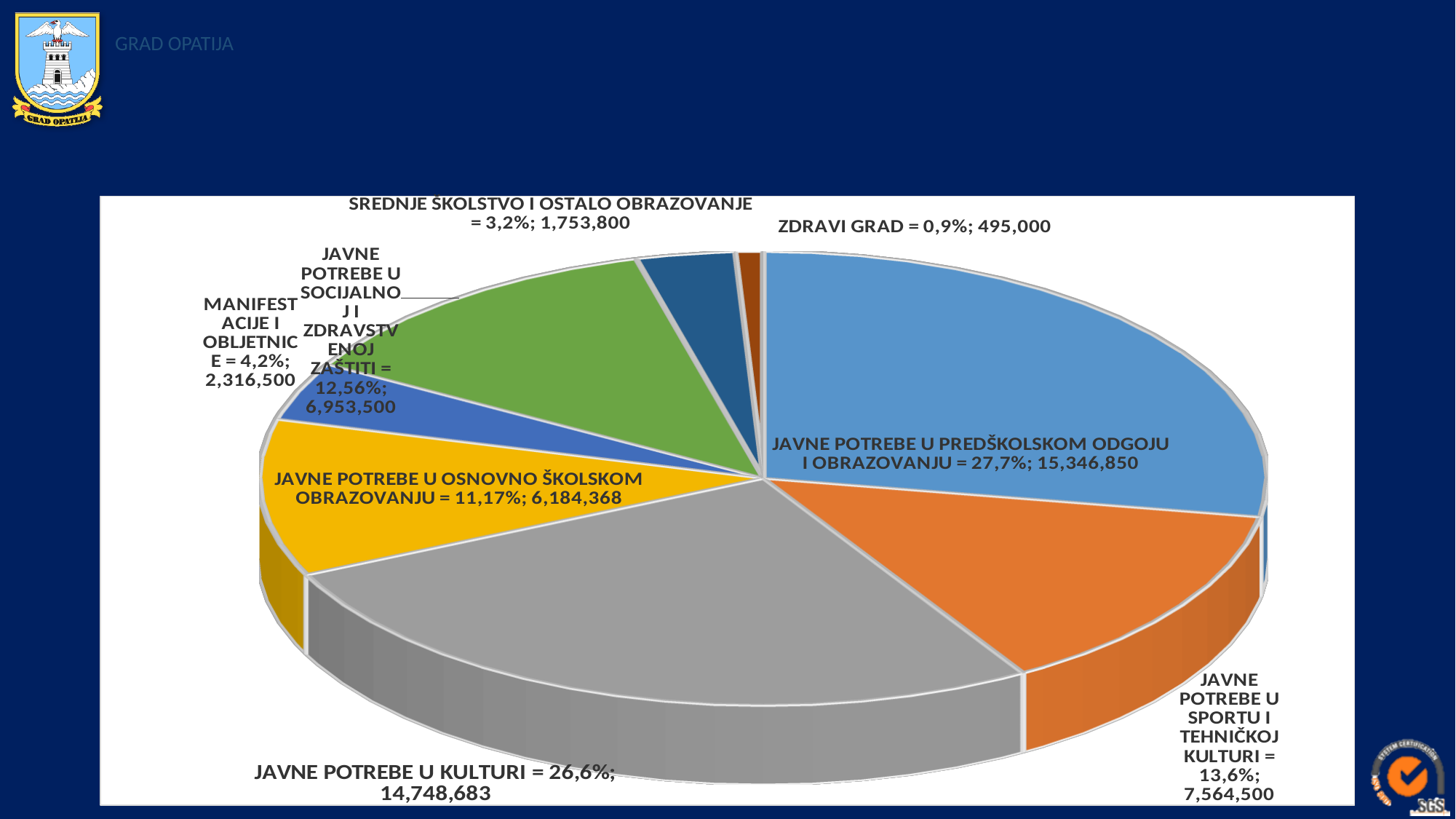
What is the value for ZDRAVI GRAD? 495,000 What is the difference between the values for JAVNE POTREBE U PREDŠKOLSKOM ODGOJU I OBRAZOVANJU and JAVNE POTREBE U KULTURI? 598,167 Which category has the smallest share of the pie? ZDRAVI GRAD What is the value for JAVNE POTREBE U KULTURI? 14,748,683 What is the value for JAVNE POTREBE U SPORTU I TEHNIČKOJ KULTURI? 7,564,500 Which is larger, the value for JAVNE POTREBE U SOCIJALNOJ I ZDRAVSTVENOJ ZAŠTITI or the value for JAVNE POTREBE U OSNOVNO ŠKOLSKOM OBRAZOVANJU? JAVNE POTREBE U SOCIJALNOJ I ZDRAVSTVENOJ ZAŠTITI How many slices does the pie chart have? 8 What is the value for MANIFESTACIJE I OBLJETNICE? 2,316,500 What share of the pie does SREDNJE ŠKOLSTVO I OSTALO OBRAZOVANJE represent? 3,2% What kind of chart is shown on the slide? pie chart What share of the pie does JAVNE POTREBE U OSNOVNO ŠKOLSKOM OBRAZOVANJU represent? 11,17% Which category has the largest share of the pie? JAVNE POTREBE U PREDŠKOLSKOM ODGOJU I OBRAZOVANJU